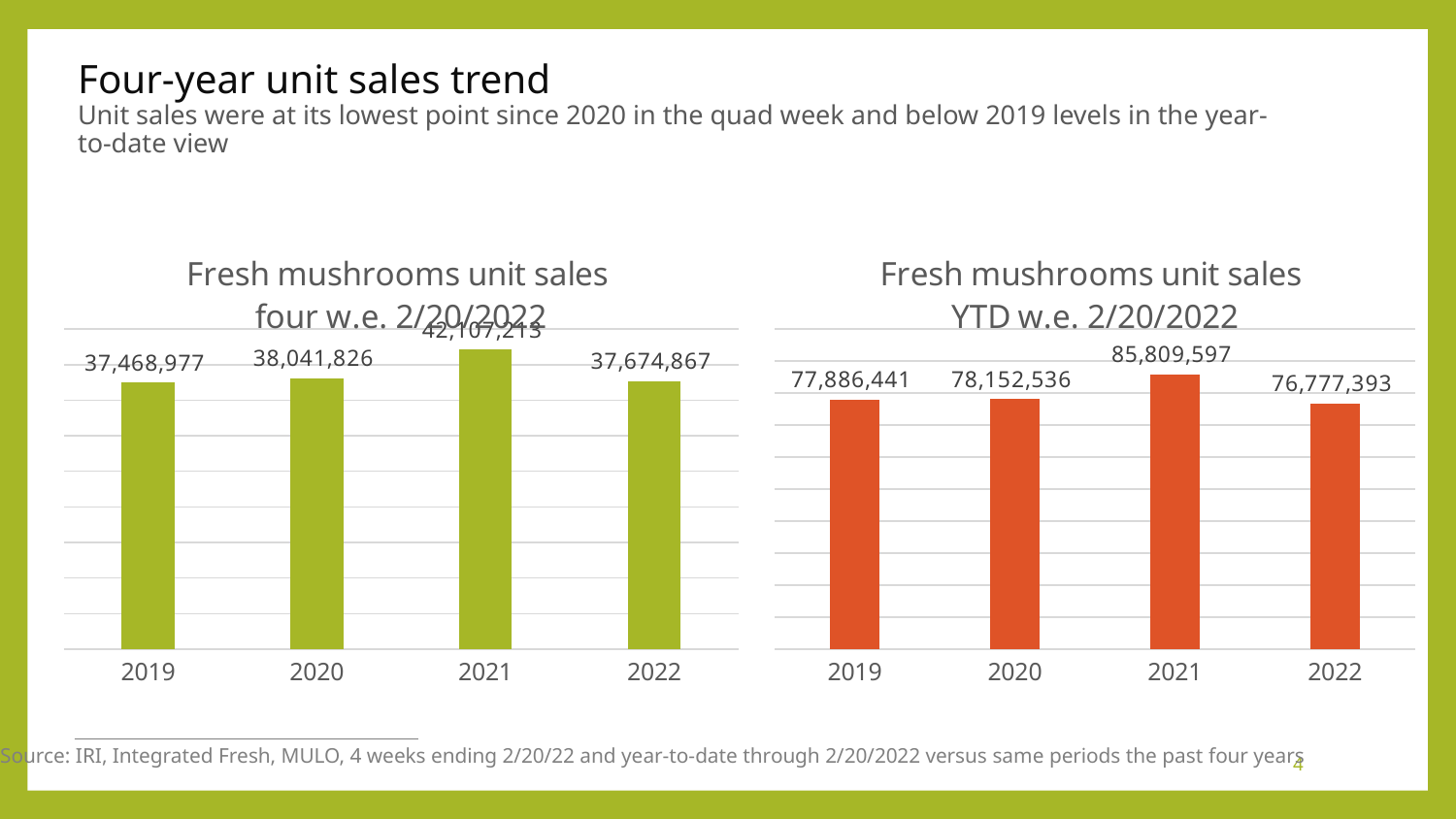
In the 'Fresh mushrooms unit sales four w.e. 2/20/2022' chart, what is the value for 2019? 37,468,977 What type of chart is the 'Fresh mushrooms unit sales YTD w.e. 2/20/2022' chart? Bar chart How many years are shown in the 'Fresh mushrooms unit sales four w.e. 2/20/2022' chart? 4 In the 'Fresh mushrooms unit sales four w.e. 2/20/2022' chart, which year has the highest value? 2021 In the 'Fresh mushrooms unit sales four w.e. 2/20/2022' chart, what is the difference between the 2020 and 2019 values? 572,849 In the 'Fresh mushrooms unit sales YTD w.e. 2/20/2022' chart, what is the value for 2022? 76,777,393 What colour are the bars in the 'Fresh mushrooms unit sales YTD w.e. 2/20/2022' chart? Orange In the 'Fresh mushrooms unit sales YTD w.e. 2/20/2022' chart, what is the difference between the 2021 and 2022 values? 9,032,204 In the 'Fresh mushrooms unit sales YTD w.e. 2/20/2022' chart, what is the value for 2021? 85,809,597 In the 'Fresh mushrooms unit sales YTD w.e. 2/20/2022' chart, which is larger, the value for 2019 or the value for 2020? 2020 In the 'Fresh mushrooms unit sales YTD w.e. 2/20/2022' chart, which year has the lowest value? 2022 In the 'Fresh mushrooms unit sales four w.e. 2/20/2022' chart, what is the value for 2022? 37,674,867